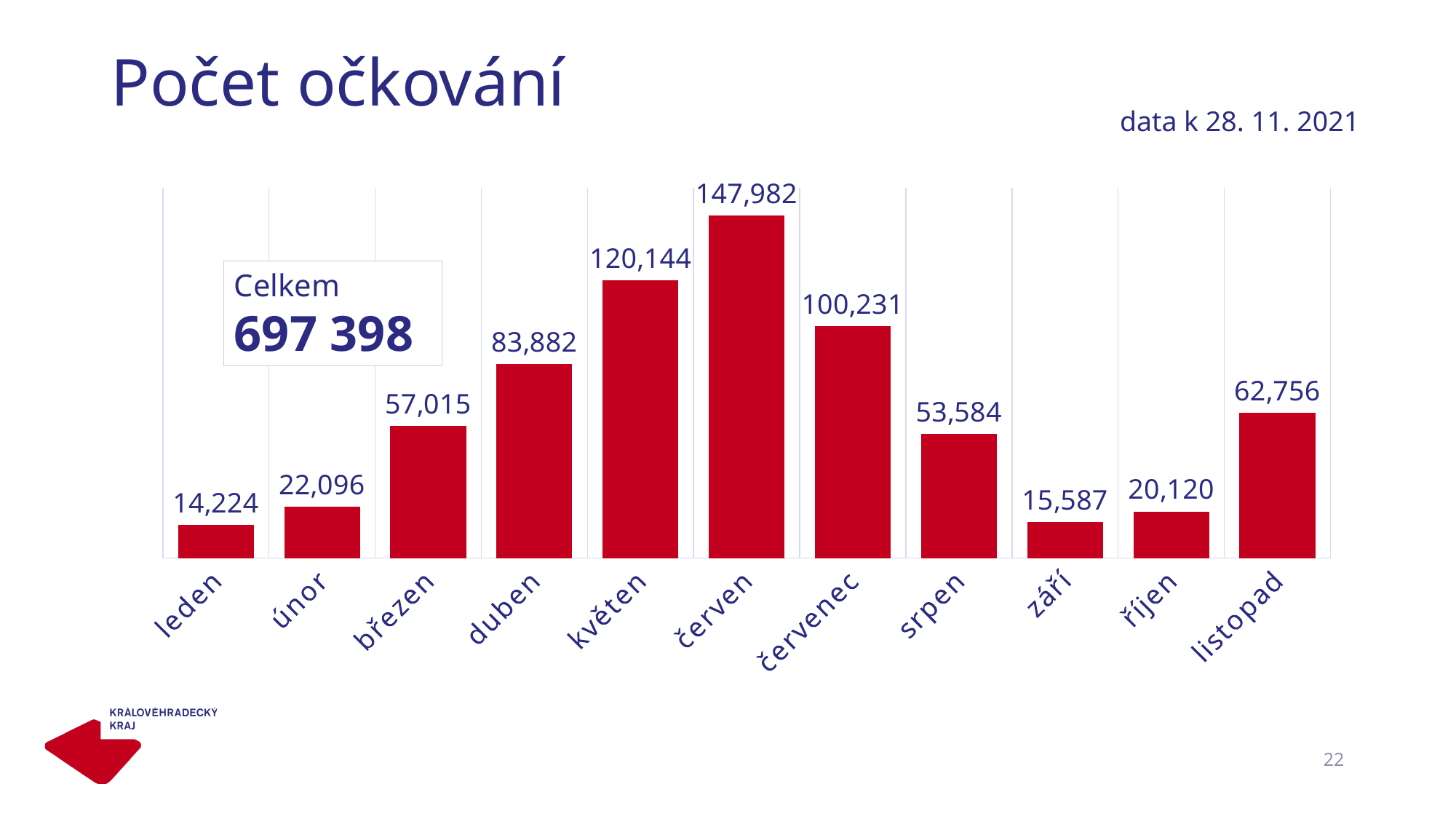
What total (Celkem) is shown in the box on the chart? 697 398 Which month has the lowest value? leden What is the value for listopad? 62,756 Which is larger, the value for duben or the value for srpen? duben Which month has the highest value? červen Do the values rise or fall from leden to červen? rise What is the difference between the values for červen and květen? 27,838 What is the value for květen? 120,144 What is the value for září? 15,587 What kind of chart is shown on the slide? bar chart How many months are shown on the x axis? 11 What is the difference between the values for listopad and říjen? 42,636